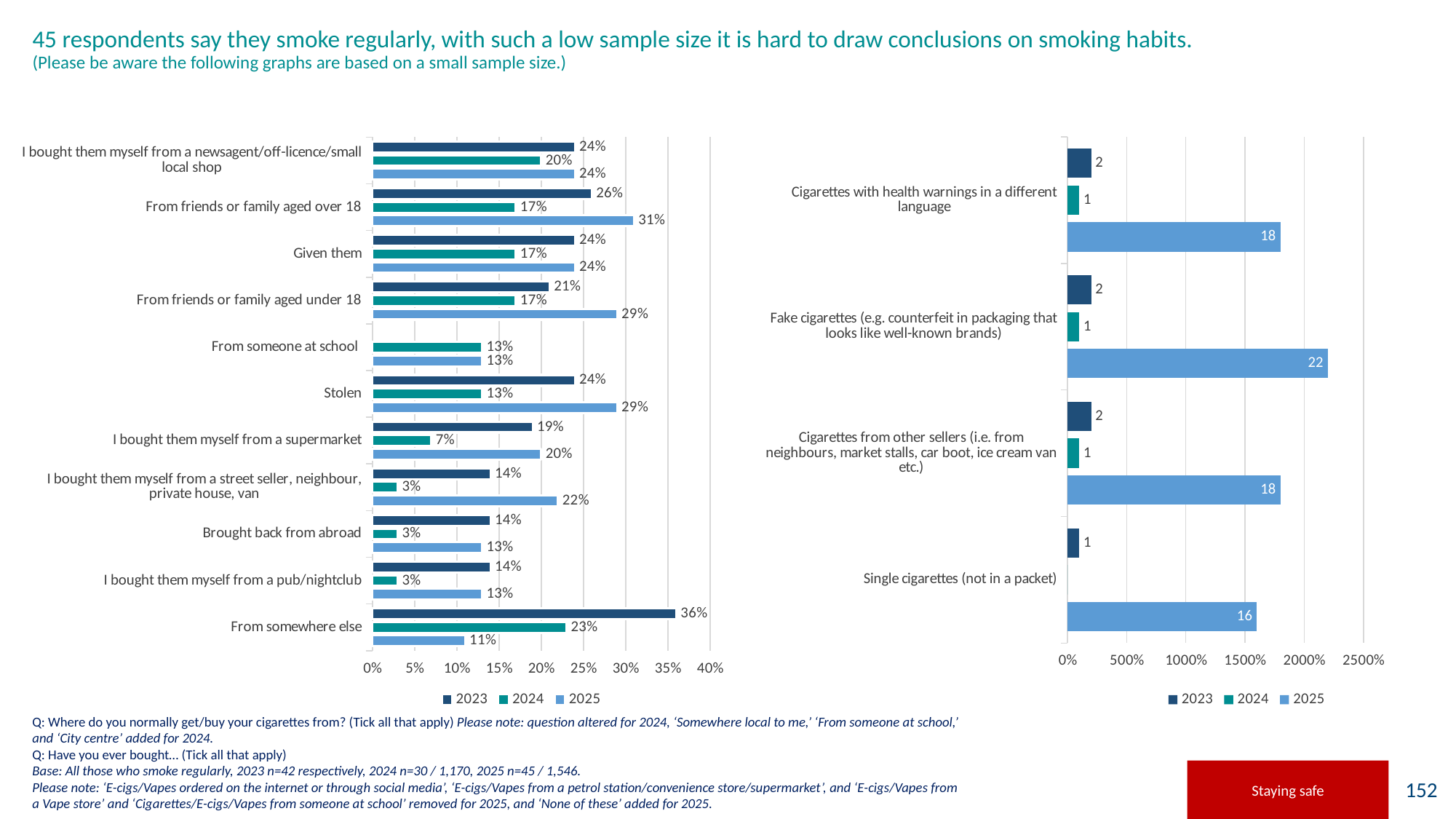
On the left chart, which category has the highest 2023 value? From somewhere else On the right chart, what is the difference between the 2025 and 2023 values for 'Cigarettes with health warnings in a different language'? 16 On the left chart, how many categories are shown? 11 On the left chart, what is the difference between the 2023 and 2025 values for 'From somewhere else'? 25% On the left chart, which is larger for 'Stolen': the 2023 value or the 2025 value? 2025 On the left chart, how many series does the legend list? 3 On the left chart, what is the 2025 value for 'From friends or family aged over 18'? 31% What kind of chart is the chart on the right? Bar chart On the left chart, what is the 2024 value for 'Brought back from abroad'? 3% On the right chart, which category has the lowest 2025 value? Single cigarettes (not in a packet) On the right chart, what is the 2025 value for 'Fake cigarettes (e.g. counterfeit in packaging that looks like well-known brands)'? 22 On the left chart, what is the 2024 value for 'I bought them myself from a supermarket'? 7%